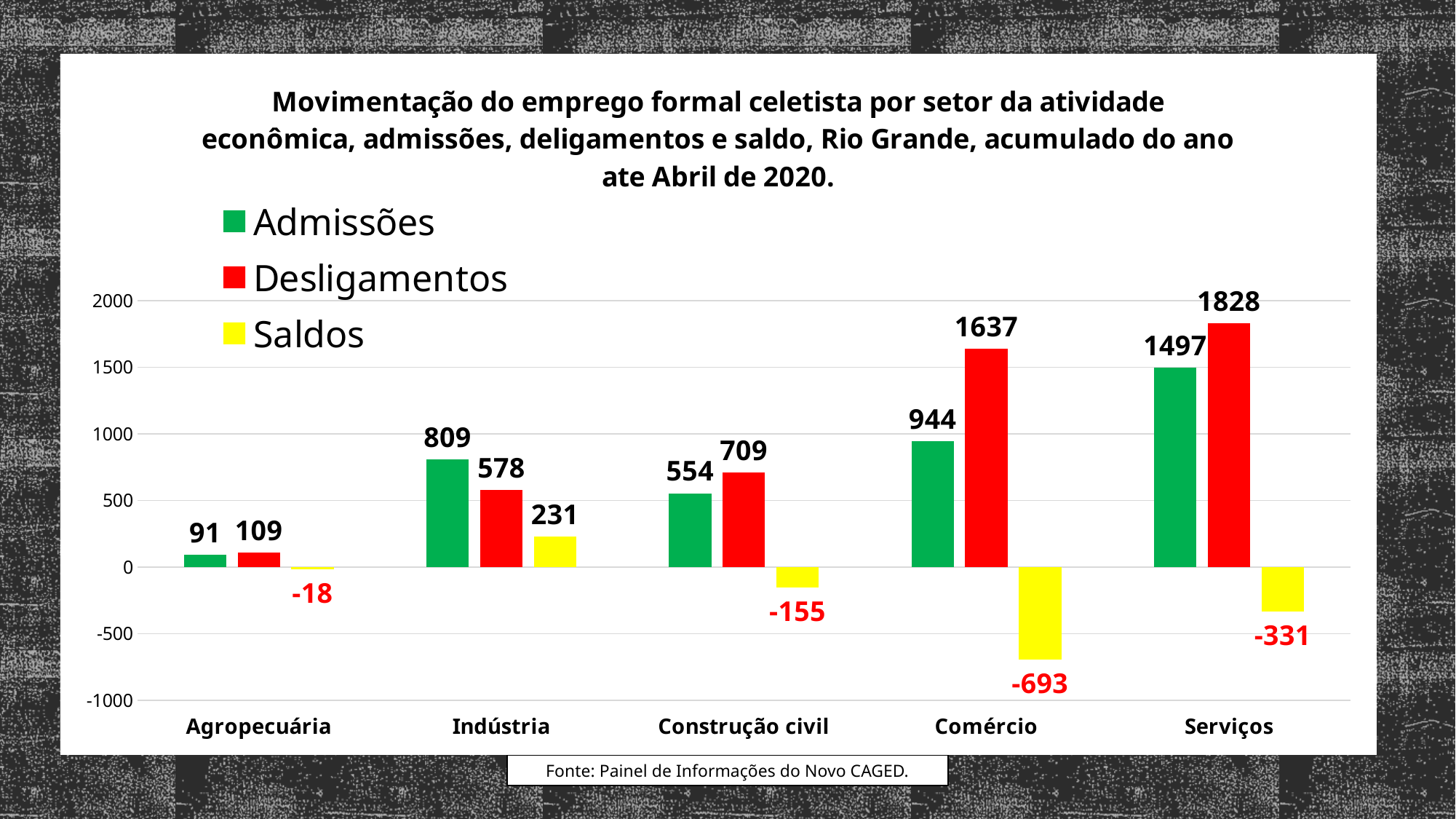
What is the value of Saldos for Serviços? -331 What is the difference between Desligamentos and Admissões for Serviços? 331 Which is larger for Indústria, Admissões or Desligamentos? Admissões Which sector has the lowest value for Admissões? Agropecuária What is the value of Admissões for Indústria? 809 How many series does the legend list? 3 Which sector has the lowest value for Saldos? Comércio What kind of chart is shown on the slide? Bar chart What colour represents the Saldos series? Yellow Which sector has the highest value for Desligamentos? Serviços How many sectors are shown on the x axis? 5 What is the value of Desligamentos for Comércio? 1637